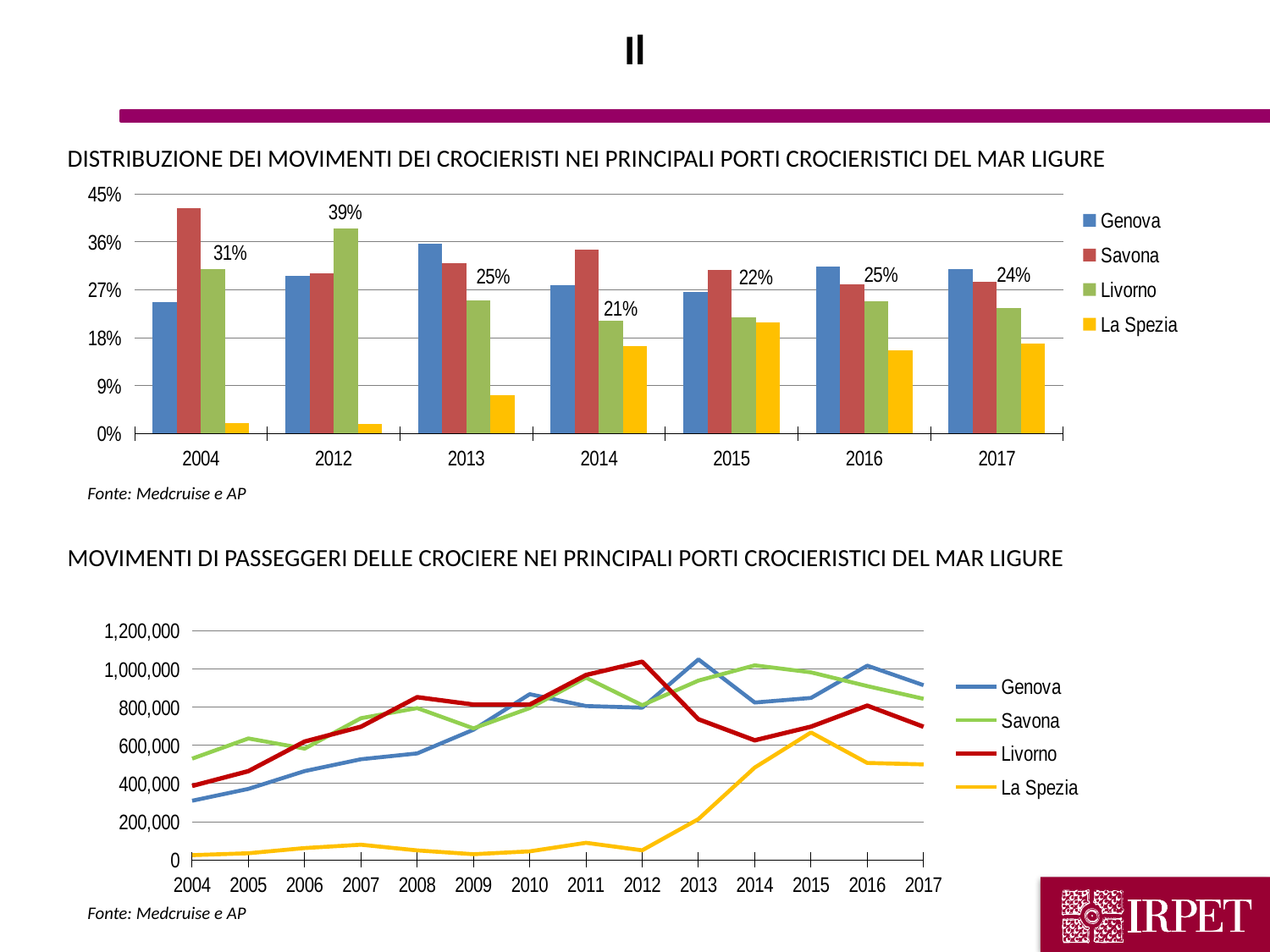
In the bottom chart (Movimenti di passeggeri delle crociere), is the value for Livorno in 2014 greater or less than 800,000? less In the top chart (Distribuzione dei movimenti dei crocieristi), how many years are shown on the x axis? 7 In the top chart (Distribuzione dei movimenti dei crocieristi), what is the value for Livorno in 2012? 39% In the top chart (Distribuzione dei movimenti dei crocieristi), in which year is the Livorno value lowest? 2014 In the bottom chart (Movimenti di passeggeri delle crociere), how many years are shown on the x axis? 14 In the top chart (Distribuzione dei movimenti dei crocieristi), is the value for La Spezia in 2004 greater or less than 9%? less What kind of chart is the bottom chart (Movimenti di passeggeri delle crociere)? line chart In the top chart (Distribuzione dei movimenti dei crocieristi), what is the value for Livorno in 2014? 21% In the top chart (Distribuzione dei movimenti dei crocieristi), is the value for Savona in 2004 greater or less than 36%? greater In the top chart (Distribuzione dei movimenti dei crocieristi), what is the difference between the Livorno values for 2012 and 2017? 15 percentage points In the top chart (Distribuzione dei movimenti dei crocieristi), in which year is the Livorno value highest? 2012 In the top chart (Distribuzione dei movimenti dei crocieristi), how many series does the legend list? 4